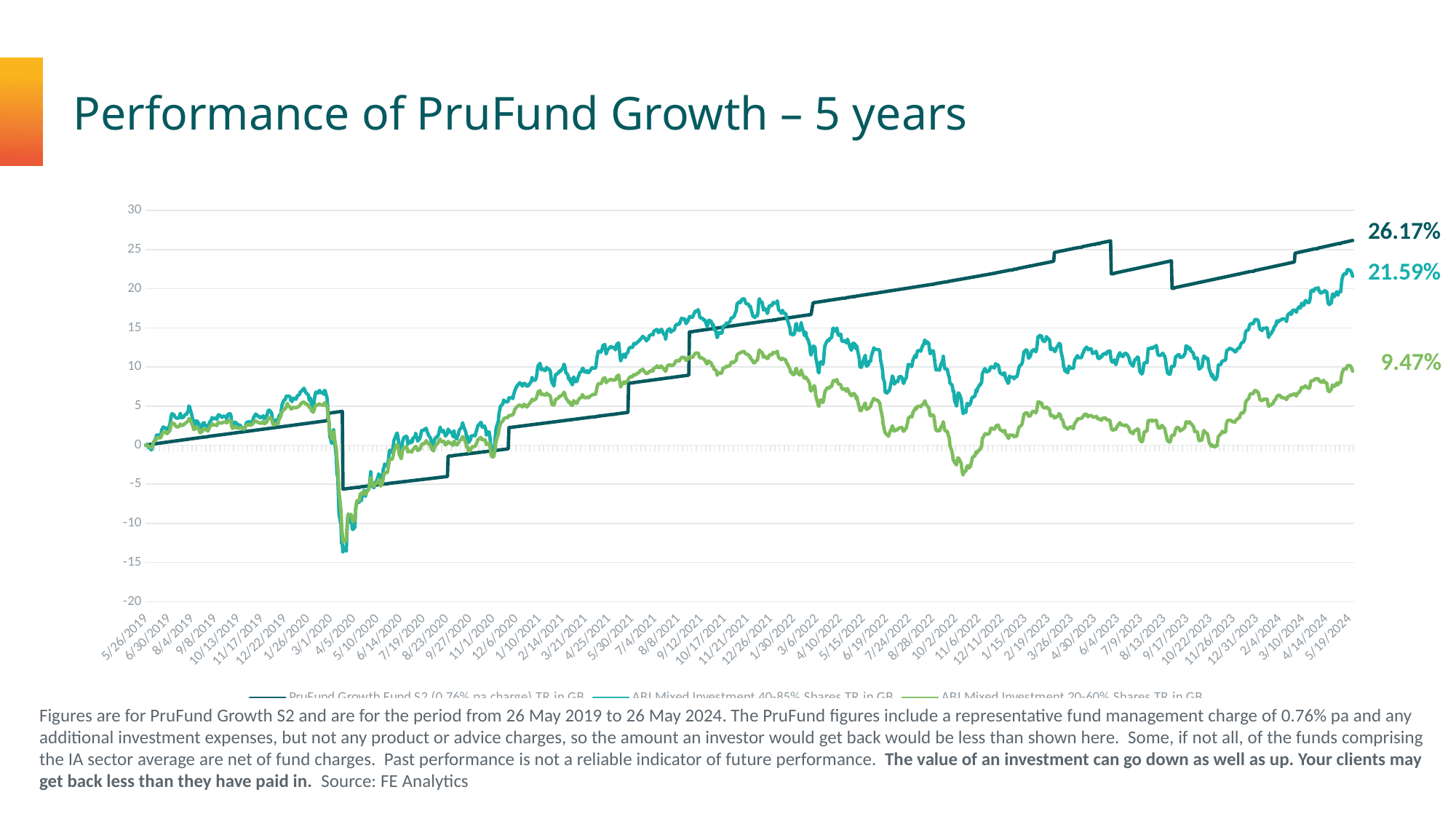
What is the final value shown for the PruFund Growth Fund S2 line? 26.17% How many series does the legend list? 3 What is the title of the slide? Performance of PruFund Growth – 5 years What is the difference between the final values of the PruFund Growth Fund S2 line and the ABI Mixed Investment 40-85% Shares line? 4.58% Over the whole period, does the PruFund Growth Fund S2 line generally rise or fall? rise Which series has the lowest value at the end of the period? ABI Mixed Investment 20-60% Shares What is the final value shown for the ABI Mixed Investment 20-60% Shares line? 9.47% What kind of chart is shown on the slide? line chart Which series has the highest value at the end of the period? PruFund Growth Fund S2 What is the final value shown for the ABI Mixed Investment 40-85% Shares line? 21.59% What is the difference between the final values of the ABI Mixed Investment 40-85% Shares line and the ABI Mixed Investment 20-60% Shares line? 12.12% Is the final value of the ABI Mixed Investment 20-60% Shares line greater or less than 10? less